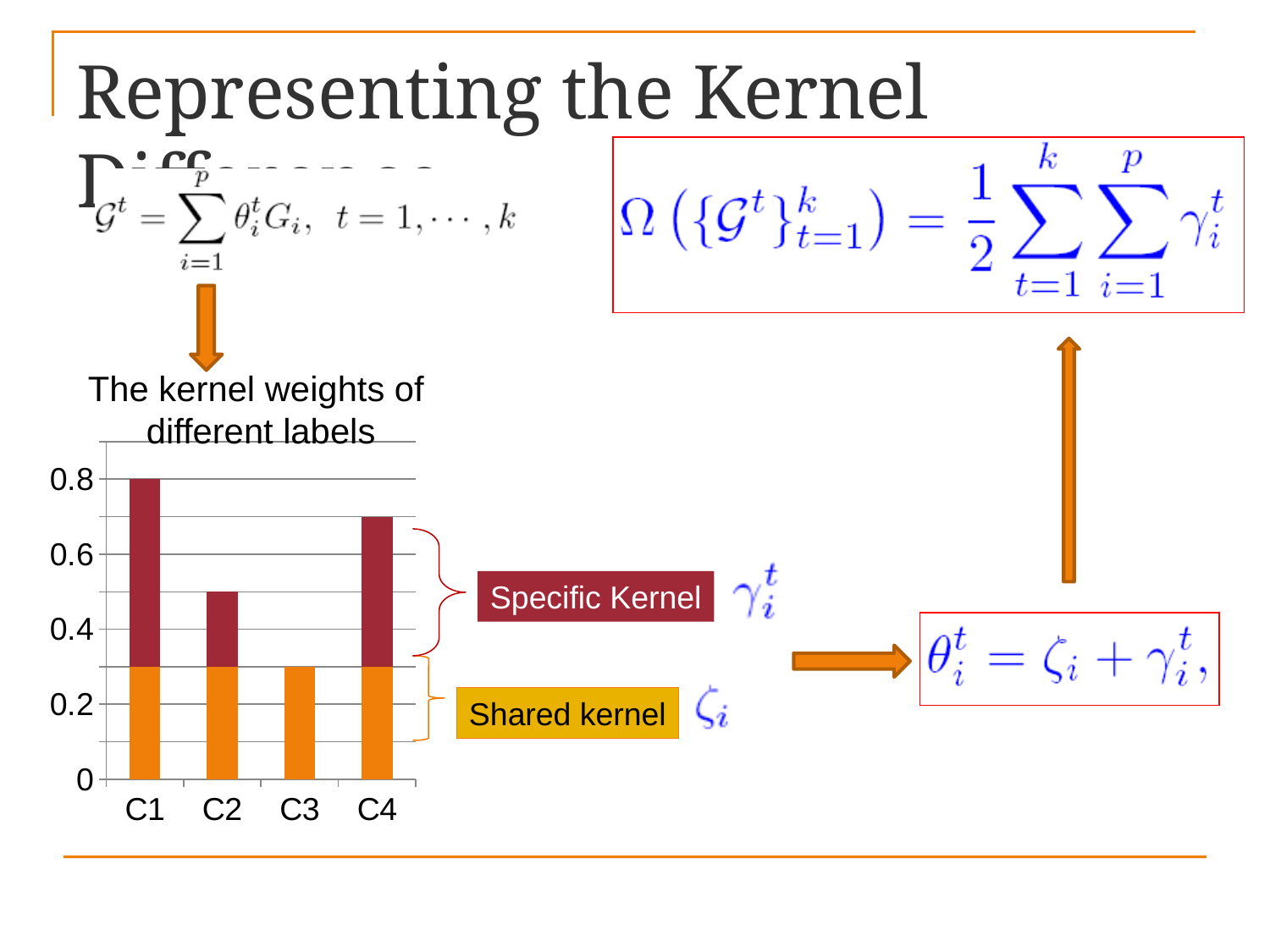
What is the title of the chart? The kernel weights of different labels Which has the larger total bar, C2 or C4? C4 What kind of chart is shown on the slide? Stacked bar chart Is the total value for C3 greater or less than 0.4? less Which category has no dark red (specific kernel) portion in its bar? C3 What is the total height of the bar for C1? 0.8 Is the total value for C2 greater or less than 0.4? greater Which category has the lowest total bar? C3 Which category has the highest total bar? C1 Is the total value for C4 greater or less than 0.6? greater How many categories are shown on the x axis of the chart? 4 Do the total bar values rise or fall from C1 to C3? fall